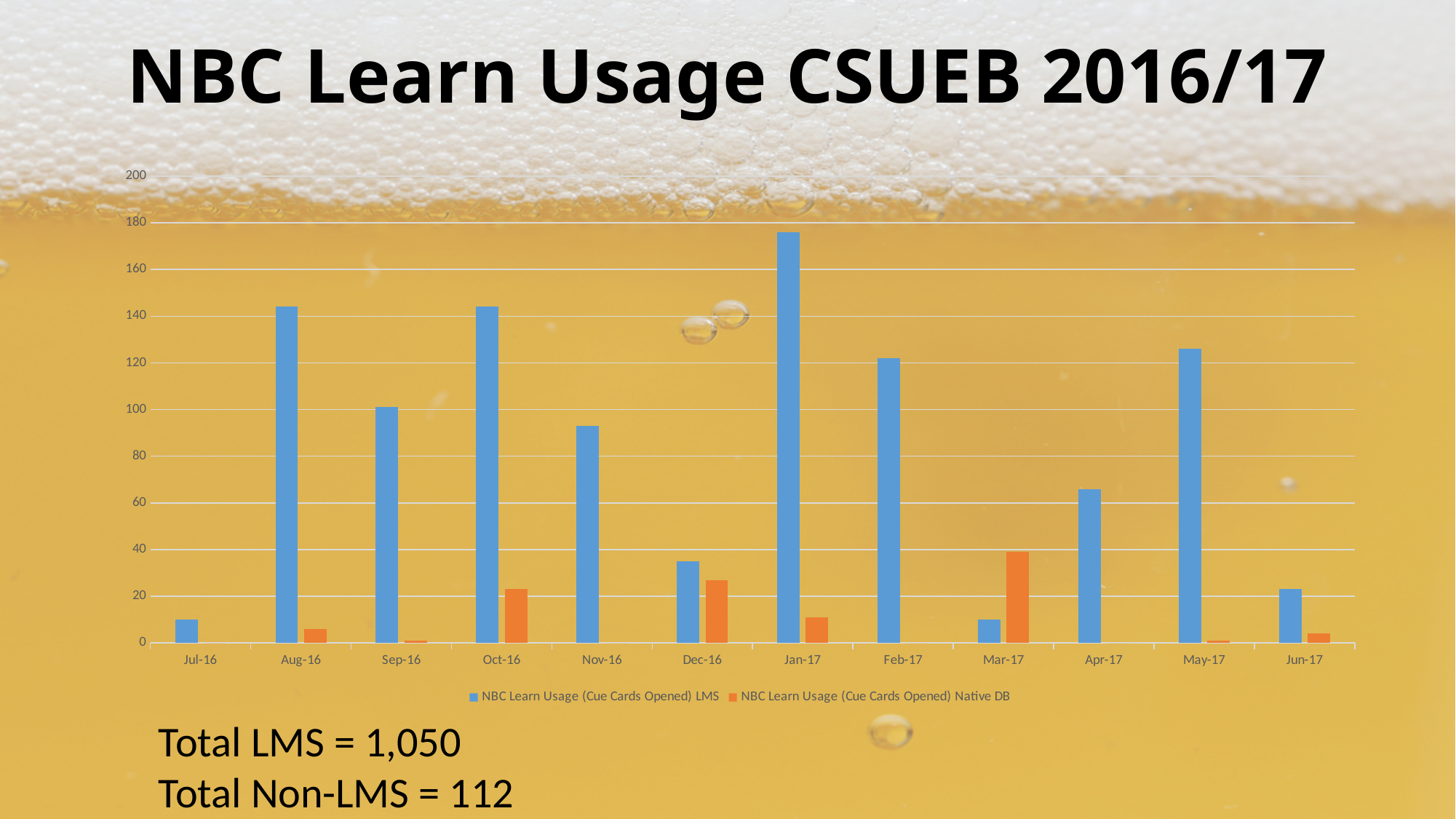
Which month has the larger LMS value, Aug-16 or Sep-16? Aug-16 Is the LMS value for Feb-17 greater or less than 100? greater Is the LMS value for Nov-16 greater or less than 100? less How many months are shown along the x axis of the chart? 12 What kind of chart is shown on the slide? bar chart How many series does the chart's legend list? 2 Which month has the larger Native DB value, Mar-17 or Jan-17? Mar-17 In which month is the NBC Learn Usage (Cue Cards Opened) Native DB value highest? Mar-17 Is the LMS value for Jan-17 greater or less than 160? greater Which colour represents the NBC Learn Usage (Cue Cards Opened) LMS series in the chart? blue In which month is the NBC Learn Usage (Cue Cards Opened) LMS value highest? Jan-17